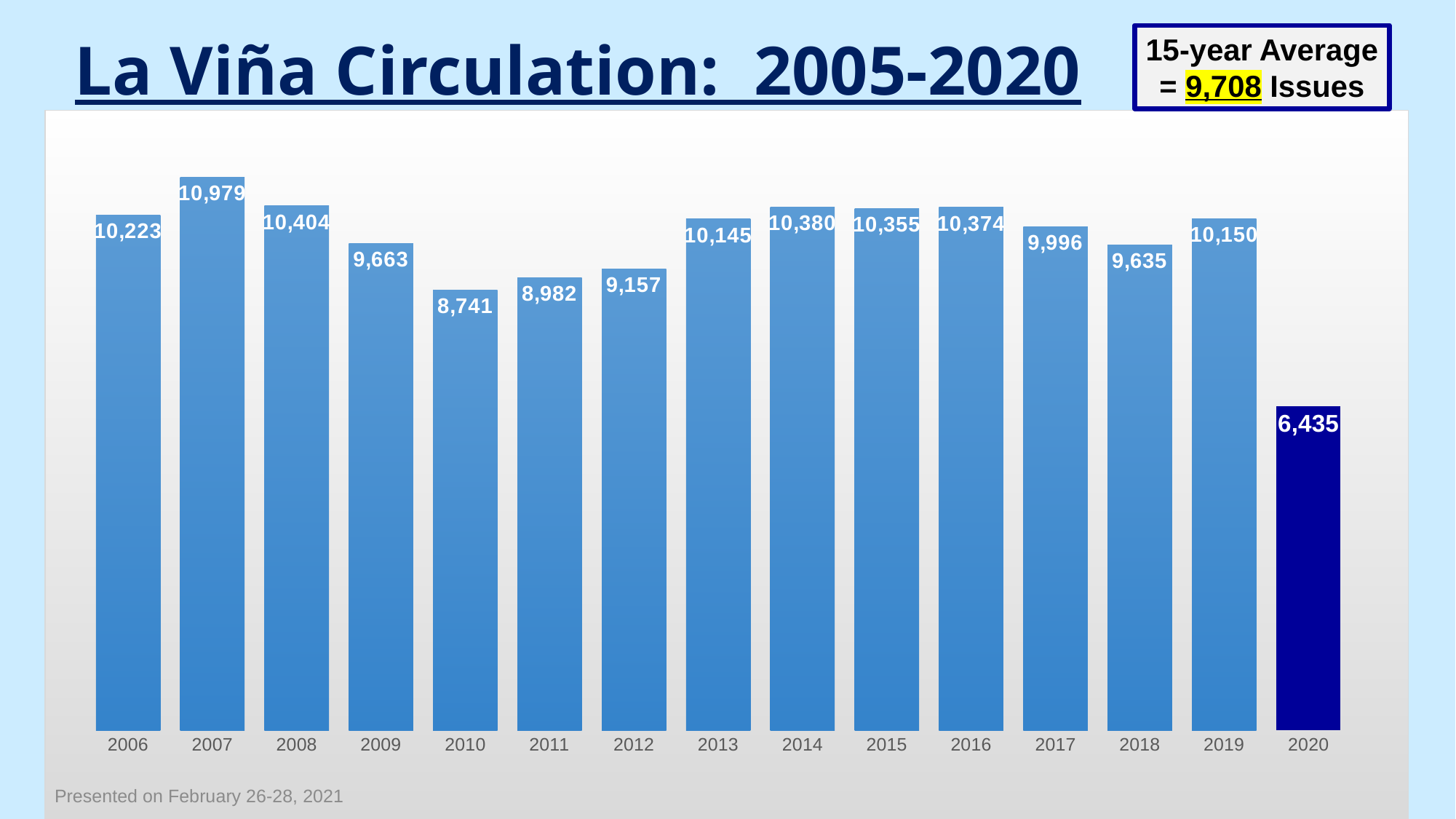
How many years are shown as bars in the chart? 15 Which year had the highest circulation? 2007 What was the circulation value for 2020? 6,435 Which year had higher circulation, 2008 or 2009? 2008 What is the difference between the 2019 and 2020 circulation values? 3,715 Which year had the lowest circulation? 2020 What was the La Viña circulation in 2010? 8,741 How much higher was circulation in 2007 than in 2006? 756 What 15-year average circulation is stated in the box at the top right of the slide? 9,708 Issues What was the circulation in 2016? 10,374 What kind of chart is shown on the slide? Bar chart Did circulation rise or fall from 2010 to 2013? Rise